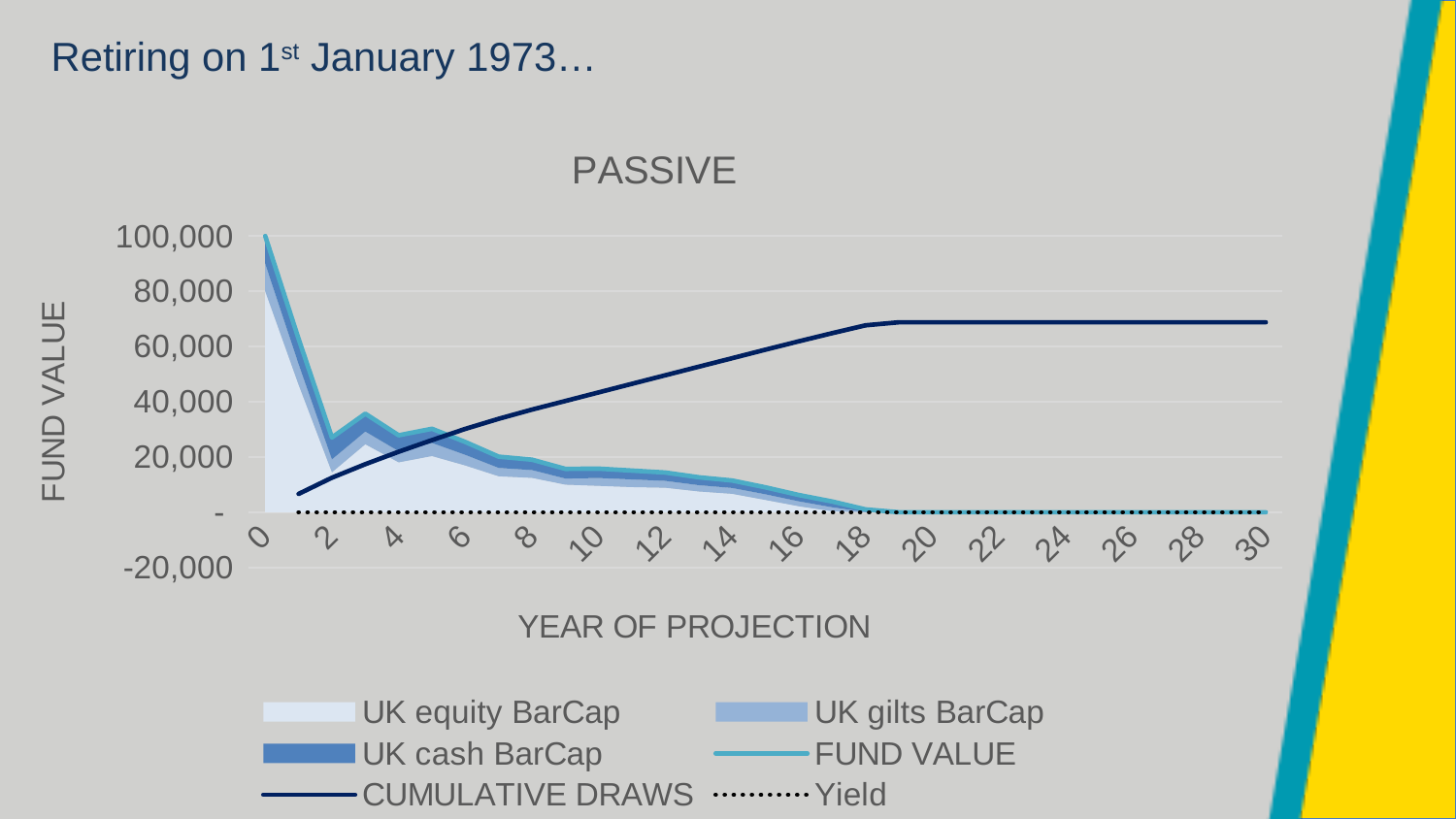
What is the highest value shown on the y axis of the chart? 100,000 What is the label on the x axis of the chart? YEAR OF PROJECTION Is the FUND VALUE at year 2 greater or less than 40,000? less Does the CUMULATIVE DRAWS series rise or fall between year 0 and year 18? rise Does the FUND VALUE series generally rise or fall from year 0 to year 18? fall Is the CUMULATIVE DRAWS value at year 30 greater or less than 60,000? greater How many series does the chart legend list? 6 What is the FUND VALUE at year 0 of the projection? 100,000 At year 20, which is larger: CUMULATIVE DRAWS or FUND VALUE? CUMULATIVE DRAWS Is the FUND VALUE at year 10 greater or less than 20,000? less What is the title of the chart? PASSIVE